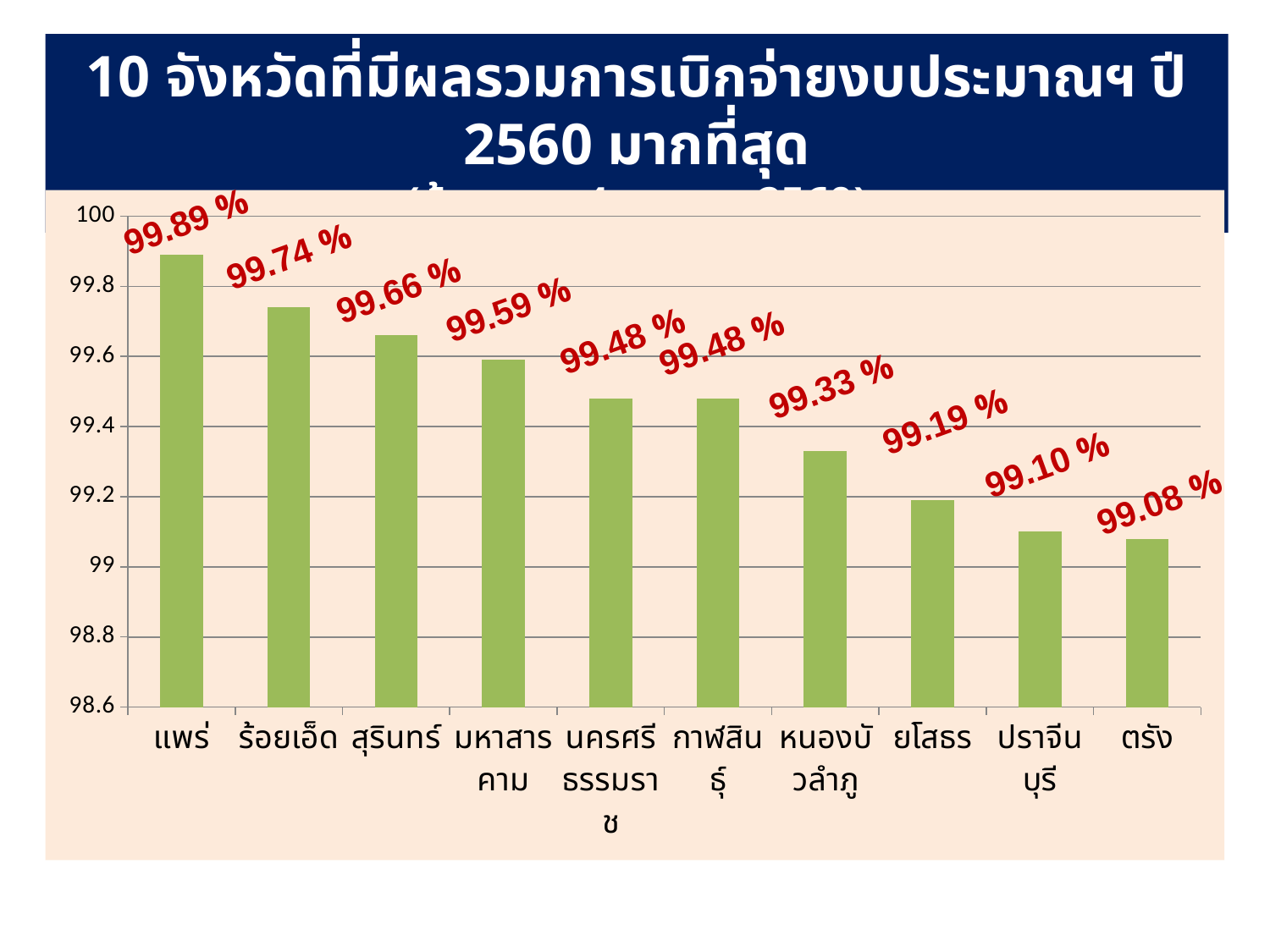
Which is larger, the value for สุรินทร์ or the value for มหาสารคาม? สุรินทร์ What is the value for แพร่? 99.89 % How many provinces are shown in the chart? 10 Which province has the highest value? แพร่ Which province has the lowest value? ตรัง What type of chart is shown on the slide? bar chart What is the value for ยโสธร? 99.19 % Is the value for ปราจีนบุรี greater or less than 99.2? less What is the value for ตรัง? 99.08 % What is the value for หนองบัวลำภู? 99.33 % What is the difference between the values for แพร่ and ตรัง? 0.81 % Do the values rise or fall from left to right along the x axis? fall